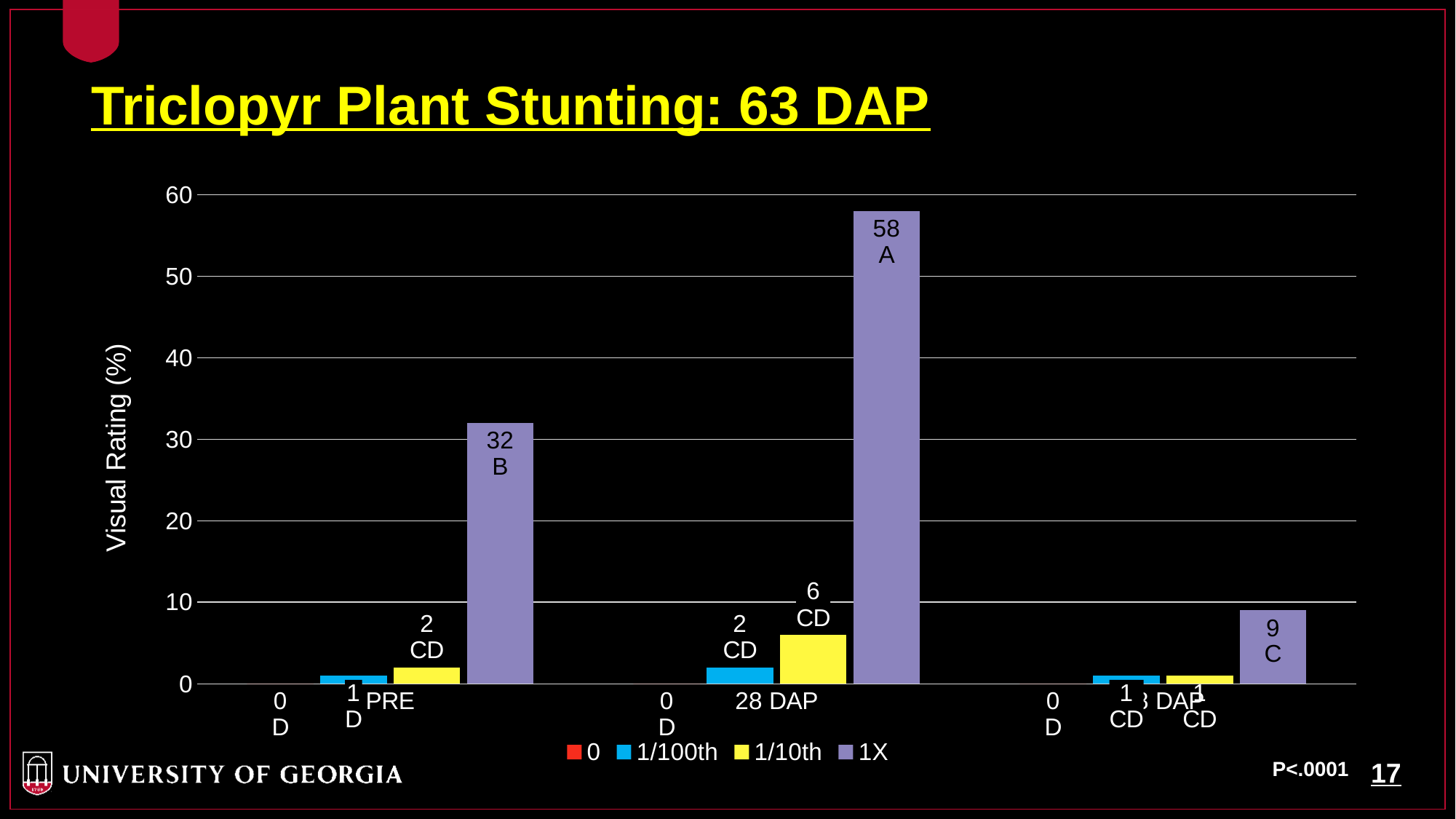
What is the value for the 1/10th series at 28 DAP? 6 What is the value for the 1/100th series at PRE? 1 What is the value for the 1X series at PRE? 32 How many series does the legend list? 4 What is the difference between the 1X value at 28 DAP and the 1X value at PRE? 26 Which is larger: the 1/10th value at PRE or the 1/10th value at 28 DAP? 28 DAP Is the value for the 1X series at 28 DAP greater or less than 50? greater What is the value for the 1X series in the rightmost group of bars? 9 What kind of chart is shown on the slide? bar chart What is the label of the y axis? Visual Rating (%) Which series has the highest value at 28 DAP? 1X What is the value for the 1X series at 28 DAP? 58